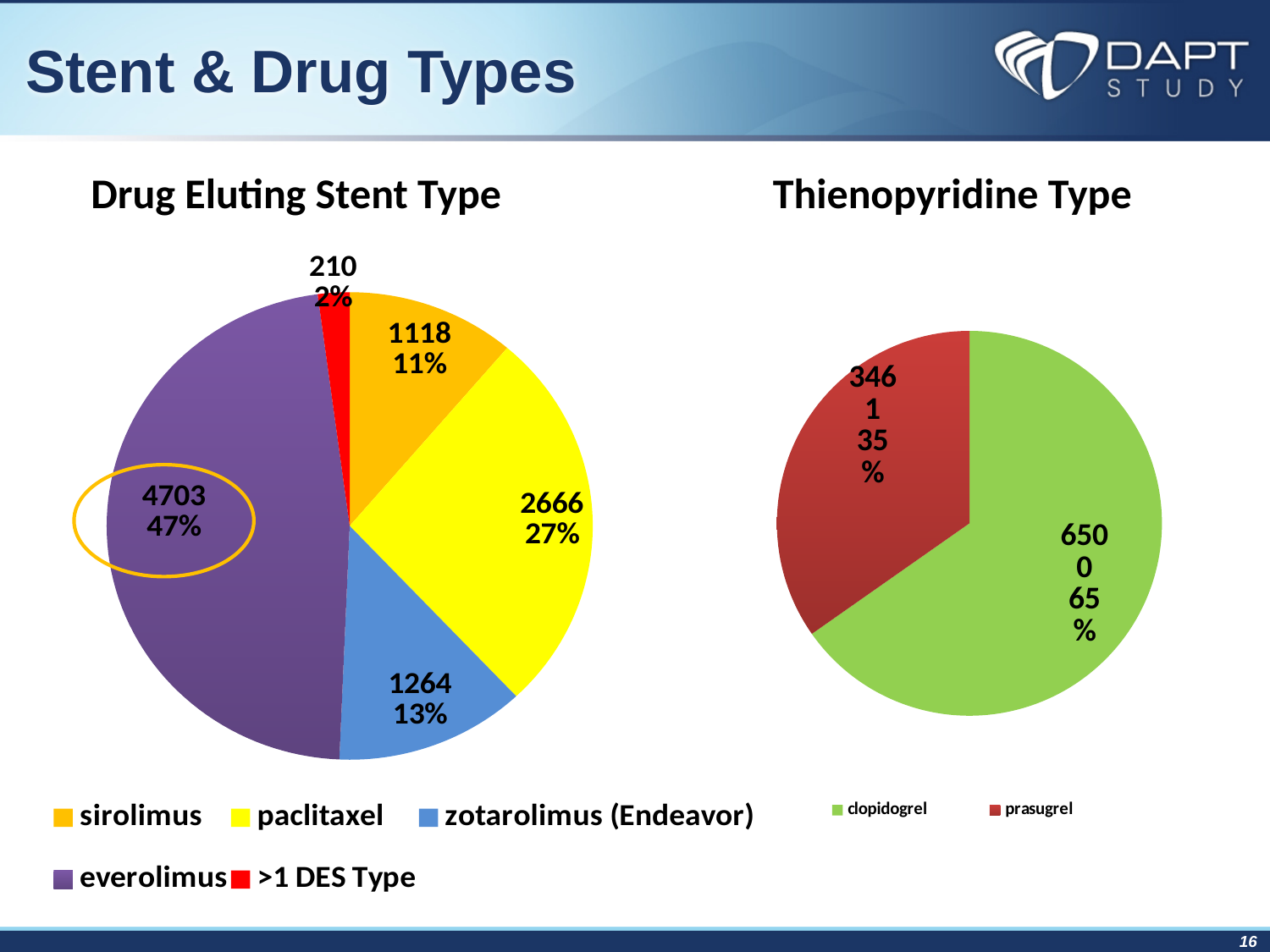
What kind of chart is the Drug Eluting Stent Type chart? pie chart In the Drug Eluting Stent Type chart, what is the difference between the paclitaxel and sirolimus values? 1548 In the Drug Eluting Stent Type chart, what is the value for zotarolimus (Endeavor)? 1264 In the Drug Eluting Stent Type chart, which category has the smallest slice? >1 DES Type In the Drug Eluting Stent Type chart, which is larger, sirolimus or zotarolimus (Endeavor)? zotarolimus (Endeavor) How many categories does the Drug Eluting Stent Type chart show? 5 In the Drug Eluting Stent Type chart, what share of the pie is paclitaxel? 27% In the Drug Eluting Stent Type chart, which category has the largest slice? everolimus In the Thienopyridine Type chart, what is the value for prasugrel? 3461 In the Drug Eluting Stent Type chart, what colour is the everolimus slice? purple In the Thienopyridine Type chart, what share of the pie is clopidogrel? 65% In the Drug Eluting Stent Type chart, what is the value for everolimus? 4703